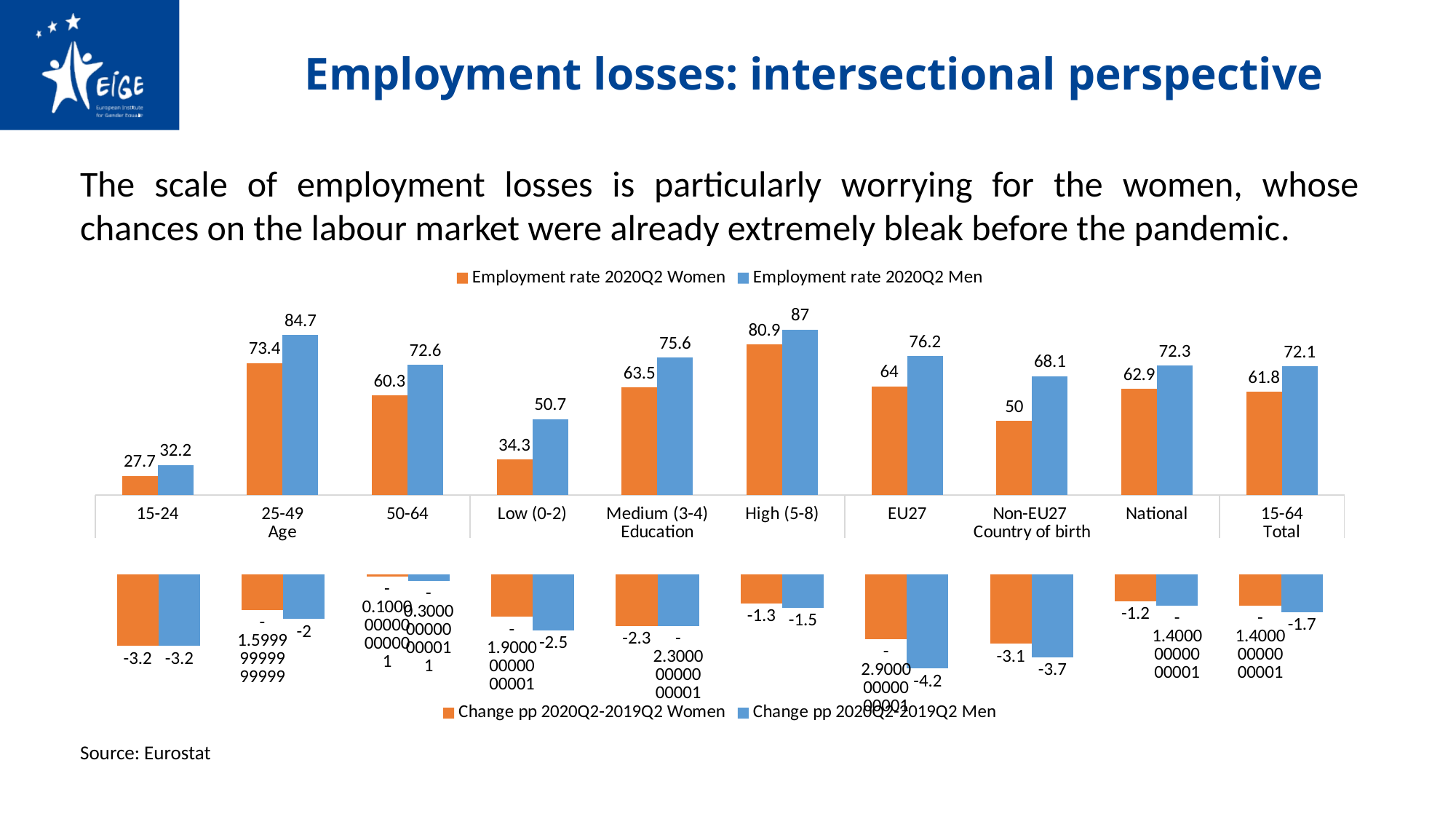
How many series does the legend of the top chart (Employment rate 2020Q2) list? 2 In the top chart (Employment rate 2020Q2), which colour represents the Women series? Orange How many categories are shown on the x axis of the top chart (Employment rate 2020Q2)? 10 In the top chart (Employment rate 2020Q2), which category has the highest employment rate for men? High (5-8) In the bottom chart (Change pp 2020Q2-2019Q2), what is the change for men in EU27? -4.2 In the top chart (Employment rate 2020Q2), which category has the lowest employment rate for women? 15-24 What type of chart is the top chart (Employment rate 2020Q2)? Bar chart In the bottom chart (Change pp 2020Q2-2019Q2), which category shows the largest decline for men? EU27 In the top chart (Employment rate 2020Q2), how much higher is the men's employment rate than the women's for Non-EU27 country of birth? 18.1 In the top chart (Employment rate 2020Q2), what is the employment rate for men with High (5-8) education? 87 In the top chart (Employment rate 2020Q2), which is larger: the women's employment rate for Low (0-2) education or for Non-EU27 country of birth? Non-EU27 In the top chart (Employment rate 2020Q2), what is the employment rate for women aged 25-49? 73.4